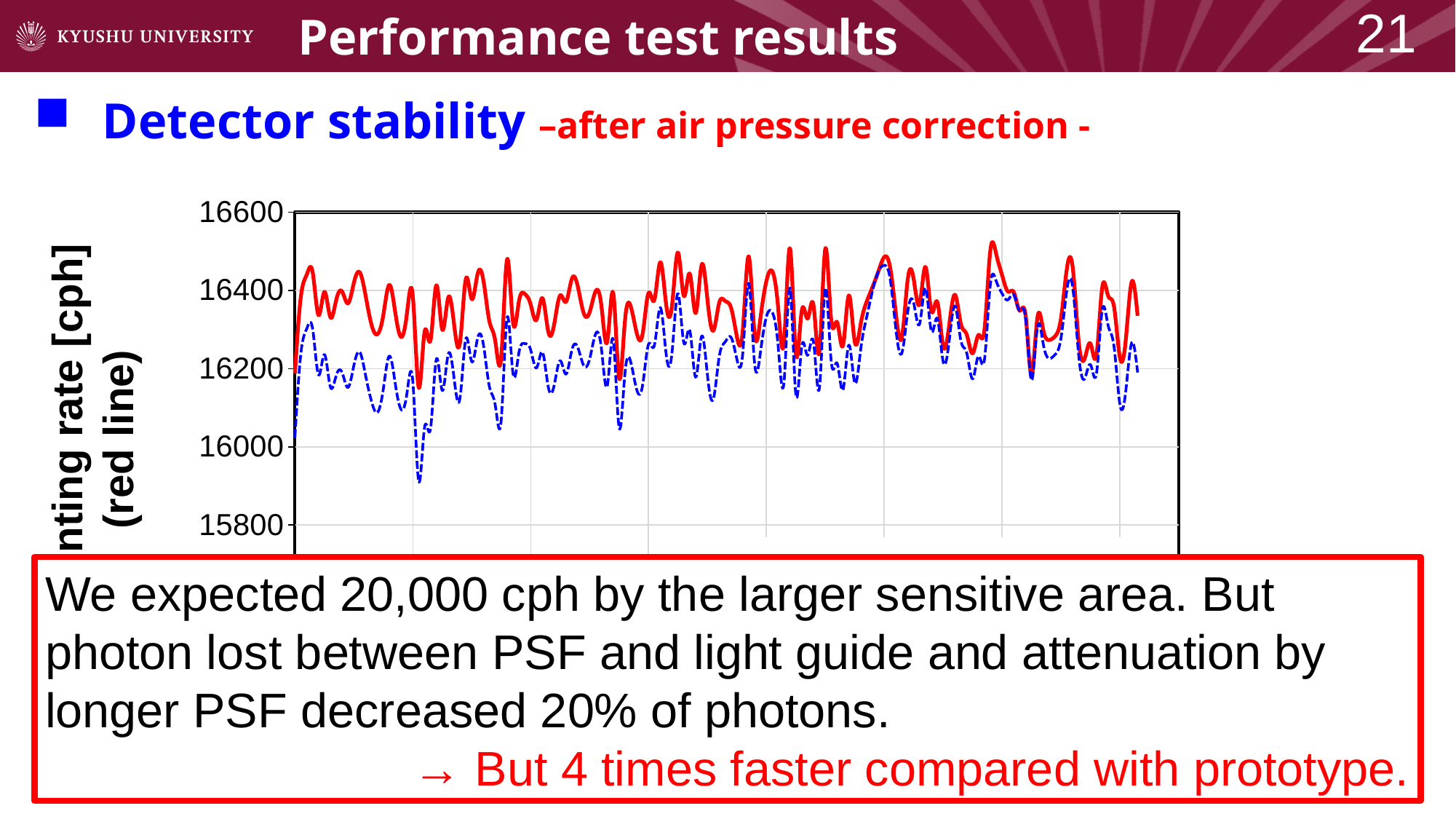
Does the red line show a strong rising or falling trend along the x axis, or does it stay roughly flat? roughly flat Is the lowest point of the blue dashed line greater or less than 16000? less What is the highest value shown on the y axis? 16600 Does the red solid line ever drop below 16000 on the chart? No How many lines (data series) are plotted on the chart? 2 Which line is generally higher on the chart, the red solid line or the blue dashed line? red solid line What kind of chart is shown on the slide? line chart What unit is given in the y-axis label? cph Is the highest point of the red solid line greater or less than 16600? less